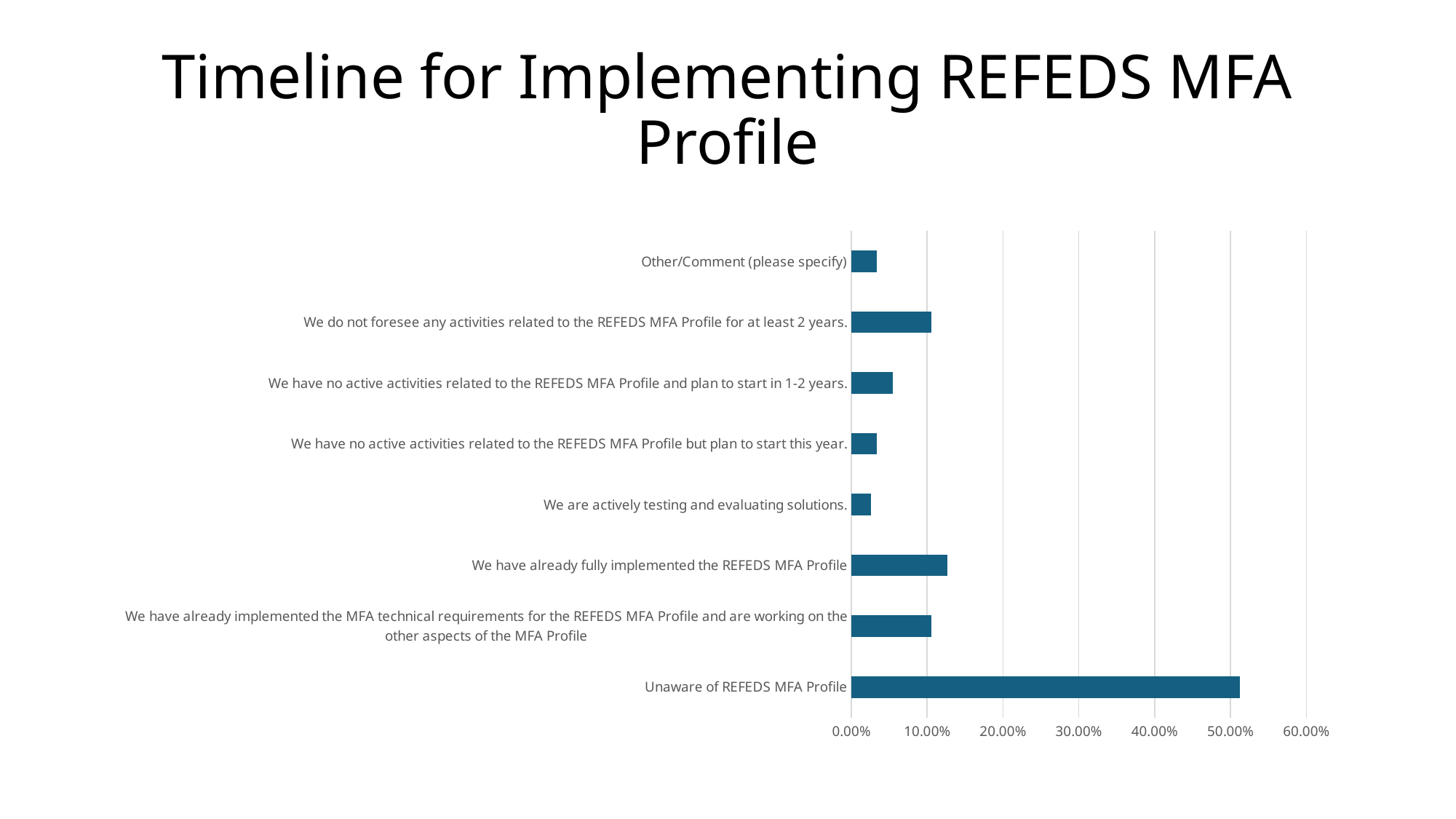
How many categories are plotted in the chart? 8 Which is larger: the value for "We have no active activities related to the REFEDS MFA Profile and plan to start in 1-2 years." or the value for "We have no active activities related to the REFEDS MFA Profile but plan to start this year."? We have no active activities related to the REFEDS MFA Profile and plan to start in 1-2 years. Which is larger: the value for "We have already fully implemented the REFEDS MFA Profile" or the value for "We have already implemented the MFA technical requirements for the REFEDS MFA Profile and are working on the other aspects of the MFA Profile"? We have already fully implemented the REFEDS MFA Profile Is the value for "Unaware of REFEDS MFA Profile" greater or less than 40.00%? greater What is the title of the slide? Timeline for Implementing REFEDS MFA Profile What kind of chart is shown on the slide? bar chart Is the value for "We have already fully implemented the REFEDS MFA Profile" greater or less than 10.00%? greater What is the highest value shown on the horizontal axis? 60.00% Is the value for "We have no active activities related to the REFEDS MFA Profile and plan to start in 1-2 years." greater or less than 10.00%? less Which category has the highest value? Unaware of REFEDS MFA Profile